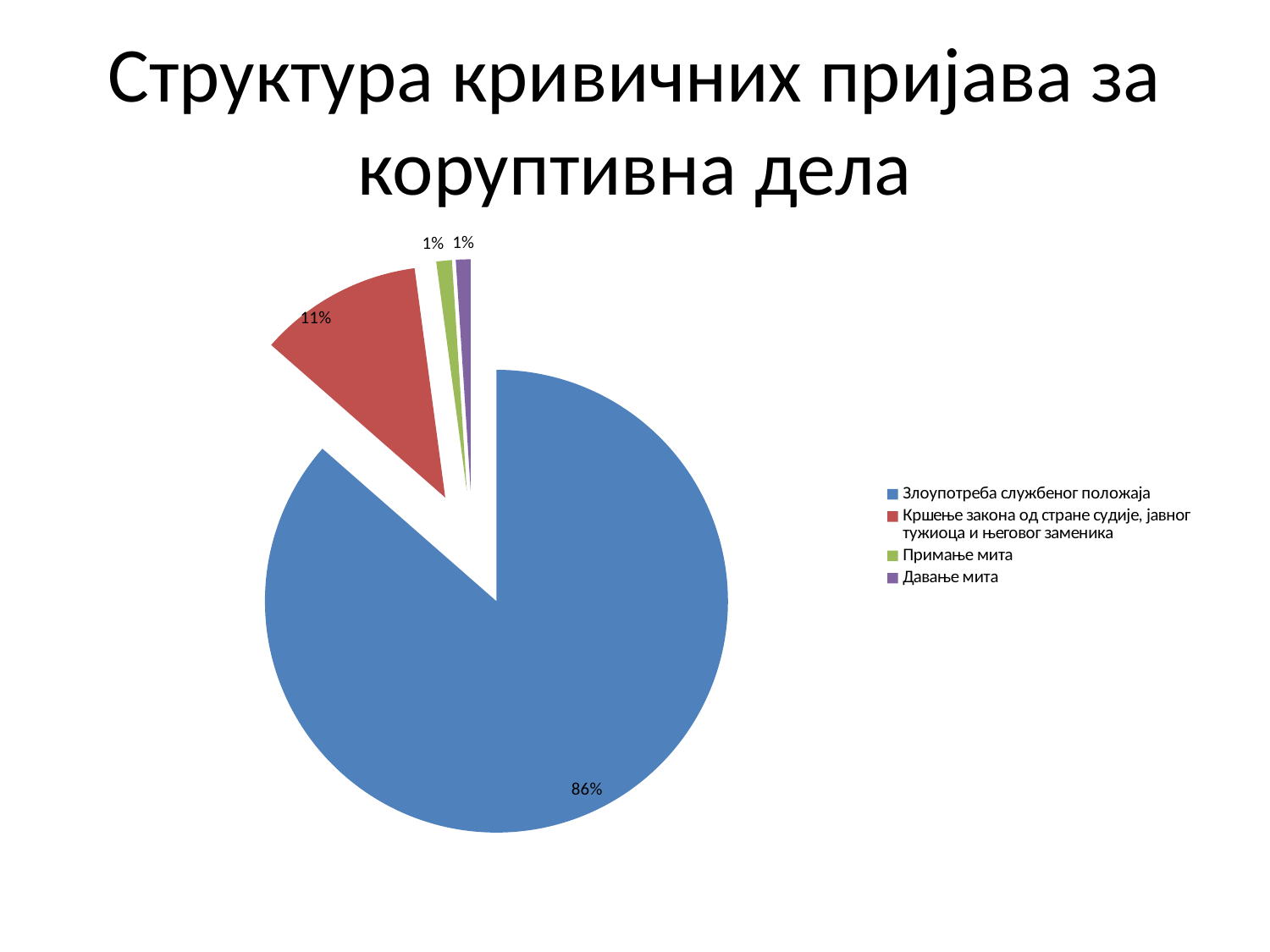
What share of the pie does Кршење закона од стране судије, јавног тужиоца и његовог заменика have? 11% Which is larger: the share of Кршење закона од стране судије, јавног тужиоца и његовог заменика or the share of Примање мита? Кршење закона од стране судије, јавног тужиоца и његовог заменика What is the combined share of Примање мита and Давање мита? 2% What share of the pie does Давање мита have? 1% What share of the pie does Злоупотреба службеног положаја have? 86% What kind of chart is shown on the slide? pie chart Which category has the largest slice of the pie? Злоупотреба службеног положаја What is the title of the slide? Структура кривичних пријава за коруптивна дела What colour is the slice for Злоупотреба службеног положаја? blue How many slices does the pie chart have? 4 What is the difference between the shares of Злоупотреба службеног положаја and Кршење закона од стране судије, јавног тужиоца и његовог заменика? 75%